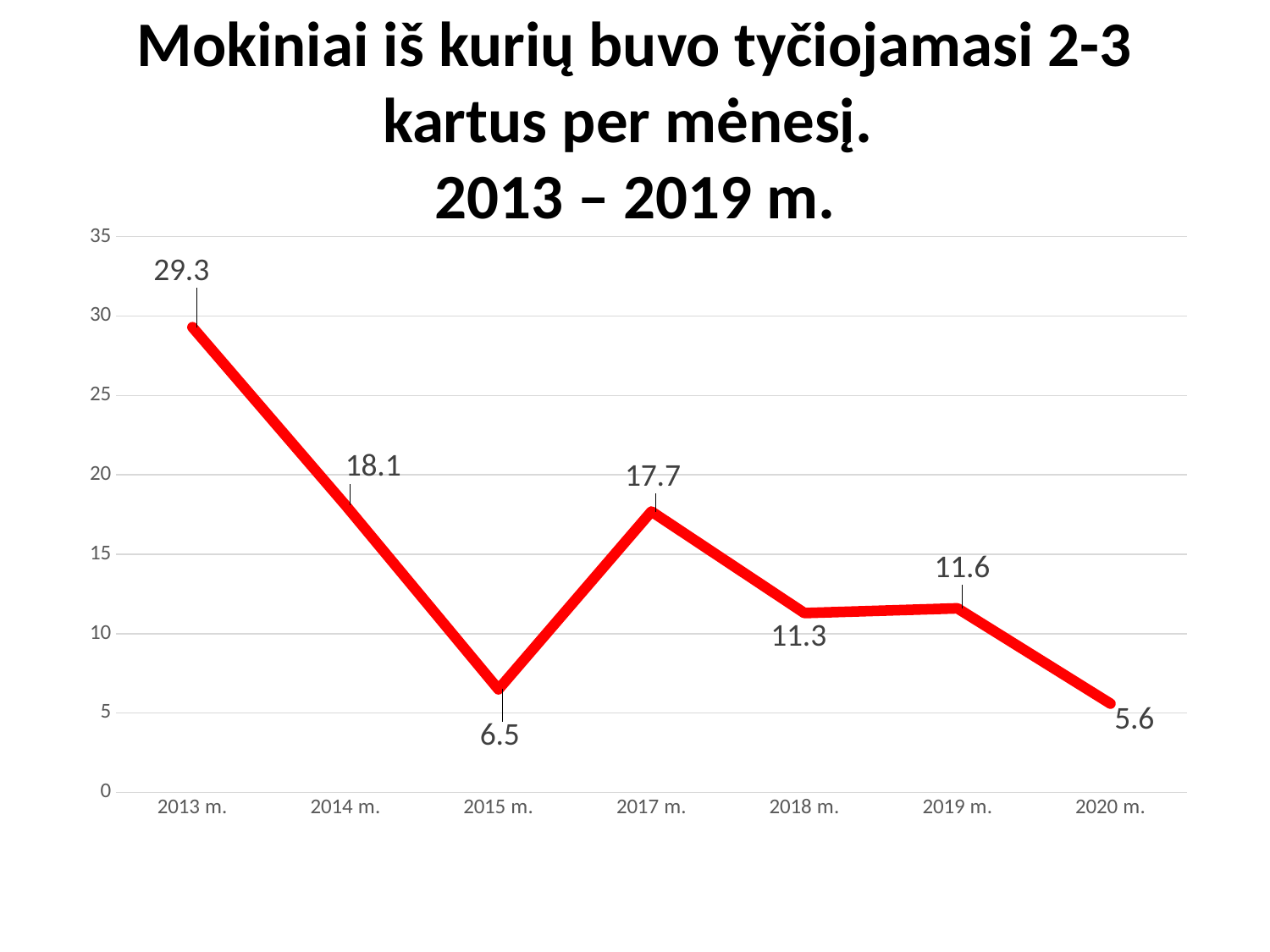
What is the value for 2018 m.? 11.3 Which year has the highest value? 2013 m. What is the value for 2015 m.? 6.5 What is the difference between the values for 2017 m. and 2015 m.? 11.2 Which year has the lowest value? 2020 m. How many data points are plotted on the chart? 7 What is the difference between the values for 2013 m. and 2014 m.? 11.2 What is the value for 2013 m.? 29.3 Which is larger, the value for 2014 m. or the value for 2017 m.? 2014 m. What is the value for 2020 m.? 5.6 Does the value rise or fall from 2015 m. to 2017 m.? rise What kind of chart is shown on the slide? line chart